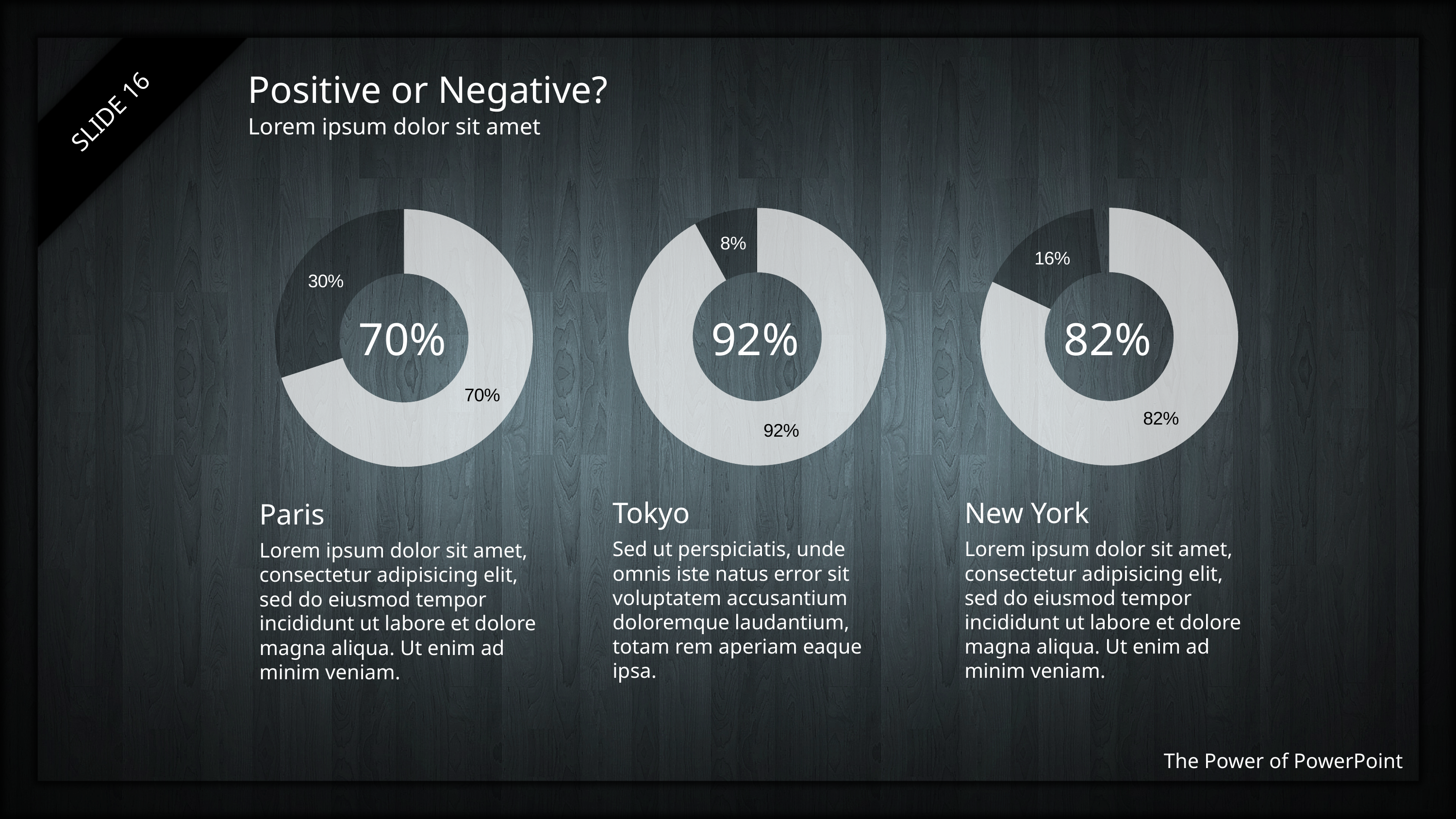
In the Paris chart, what is the value of the smaller, darker slice? 30% In the Tokyo chart, what is the value of the smaller, darker slice? 8% In the New York chart, what percentage is shown in the centre? 82% Which city's chart shows the highest centre percentage? Tokyo What is the difference between the Tokyo centre value and the Paris centre value? 22% In the Tokyo chart, what percentage is shown in the centre? 92% Which city's chart shows the lowest centre percentage? Paris Which is larger: the New York centre value or the Paris centre value? New York In the Paris chart, what percentage is shown in the centre? 70% In the New York chart, what is the value of the smaller, darker slice? 16% What kind of chart is used for Paris, Tokyo and New York on this slide? Doughnut chart How many doughnut charts are on the slide? 3